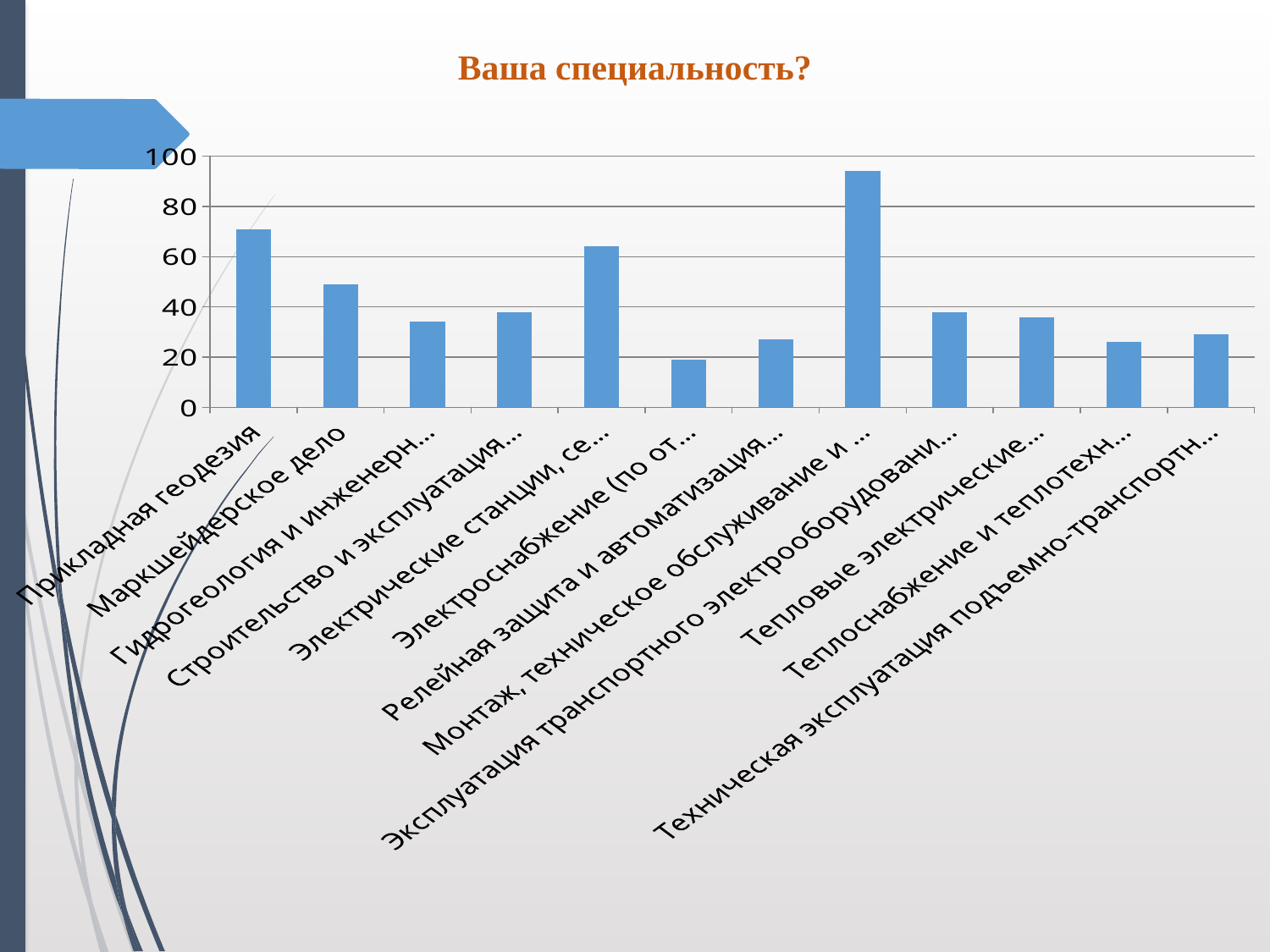
Which is larger, the value for Электрические станции, се... or the value for Релейная защита и автоматизация...? Электрические станции, се... Which is larger, the value for Прикладная геодезия or the value for Маркшейдерское дело? Прикладная геодезия What is the title of the chart? Ваша специальность? Is the value for Прикладная геодезия greater or less than 60? greater Which category has the highest bar? Монтаж, техническое обслуживание и ... How many categories (specialties) are plotted on the chart? 12 Is the value for Маркшейдерское дело greater or less than 40? greater Which category has the lowest bar? Электроснабжение (по от... Is the value for Монтаж, техническое обслуживание и ... greater or less than 80? greater What kind of chart is shown on the slide? bar chart